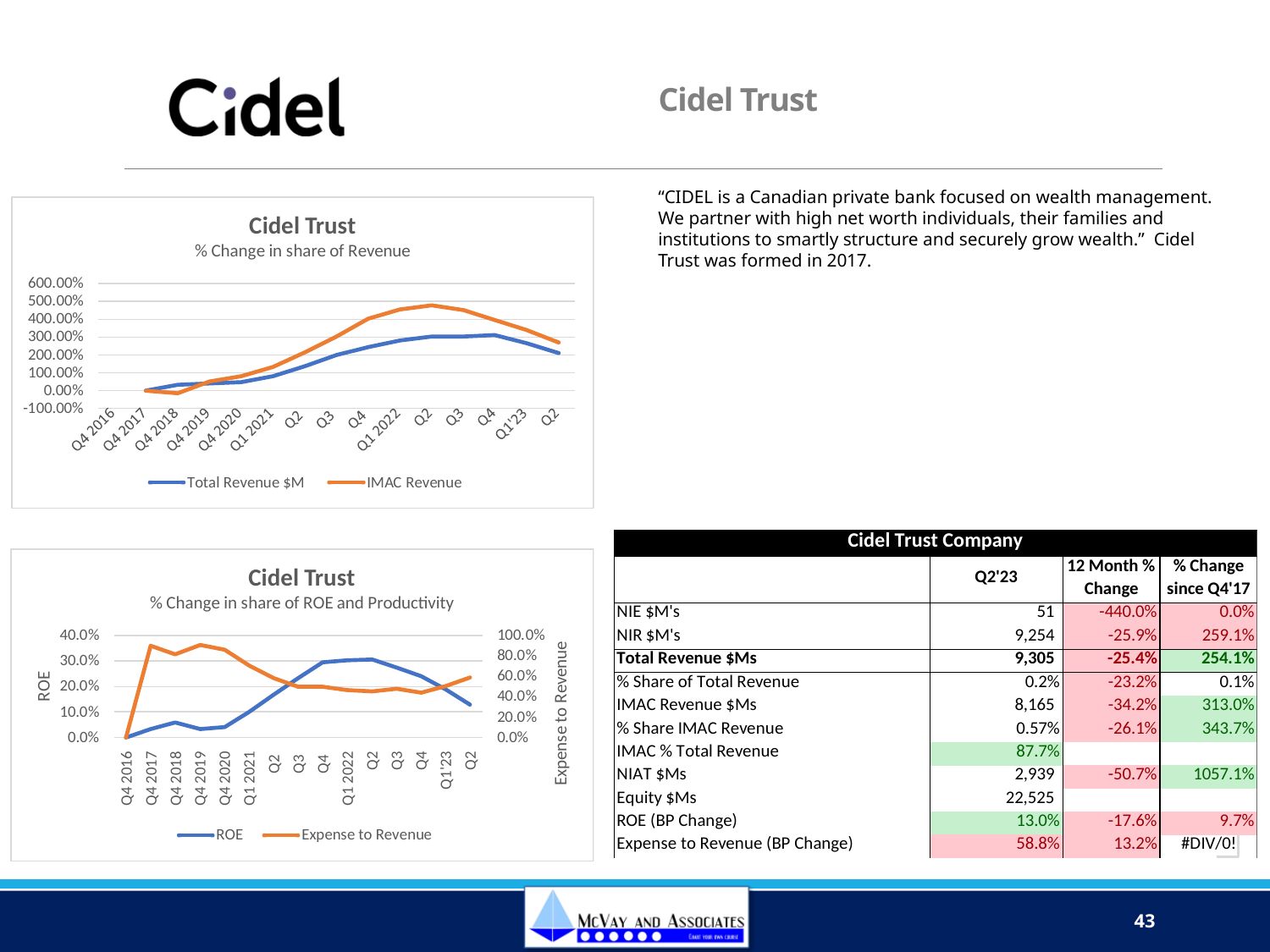
In the top-left chart (% Change in share of Revenue), does the Total Revenue $M line rise or fall from Q4 2017 to Q4 2022? Rise How many series does the legend of the bottom-left chart (% Change in share of ROE and Productivity) list? 2 In the top-left chart (% Change in share of Revenue), is the Total Revenue $M value at Q2 2022 greater or less than 400.00%? less In the bottom-left chart (% Change in share of ROE and Productivity), is the ROE value at Q4 2022 greater or less than 20.0%? greater In the top-left chart (% Change in share of Revenue), which series is higher at Q2 2022, Total Revenue $M or IMAC Revenue? IMAC Revenue What type of chart is the top-left chart titled "Cidel Trust % Change in share of Revenue"? Line chart In the top-left chart (% Change in share of Revenue), is the IMAC Revenue value at Q2 2022 greater or less than 400.00%? greater How many series does the legend of the top-left chart (% Change in share of Revenue) list? 2 What type of chart is the bottom-left chart titled "Cidel Trust % Change in share of ROE and Productivity"? Line chart In the bottom-left chart (% Change in share of ROE and Productivity), does the Expense to Revenue line rise or fall from Q4 2019 to Q3 2021? Fall How many x-axis categories are shown in the top-left chart (% Change in share of Revenue)? 15 What are the two series named in the legend of the top-left chart (% Change in share of Revenue)? Total Revenue $M and IMAC Revenue